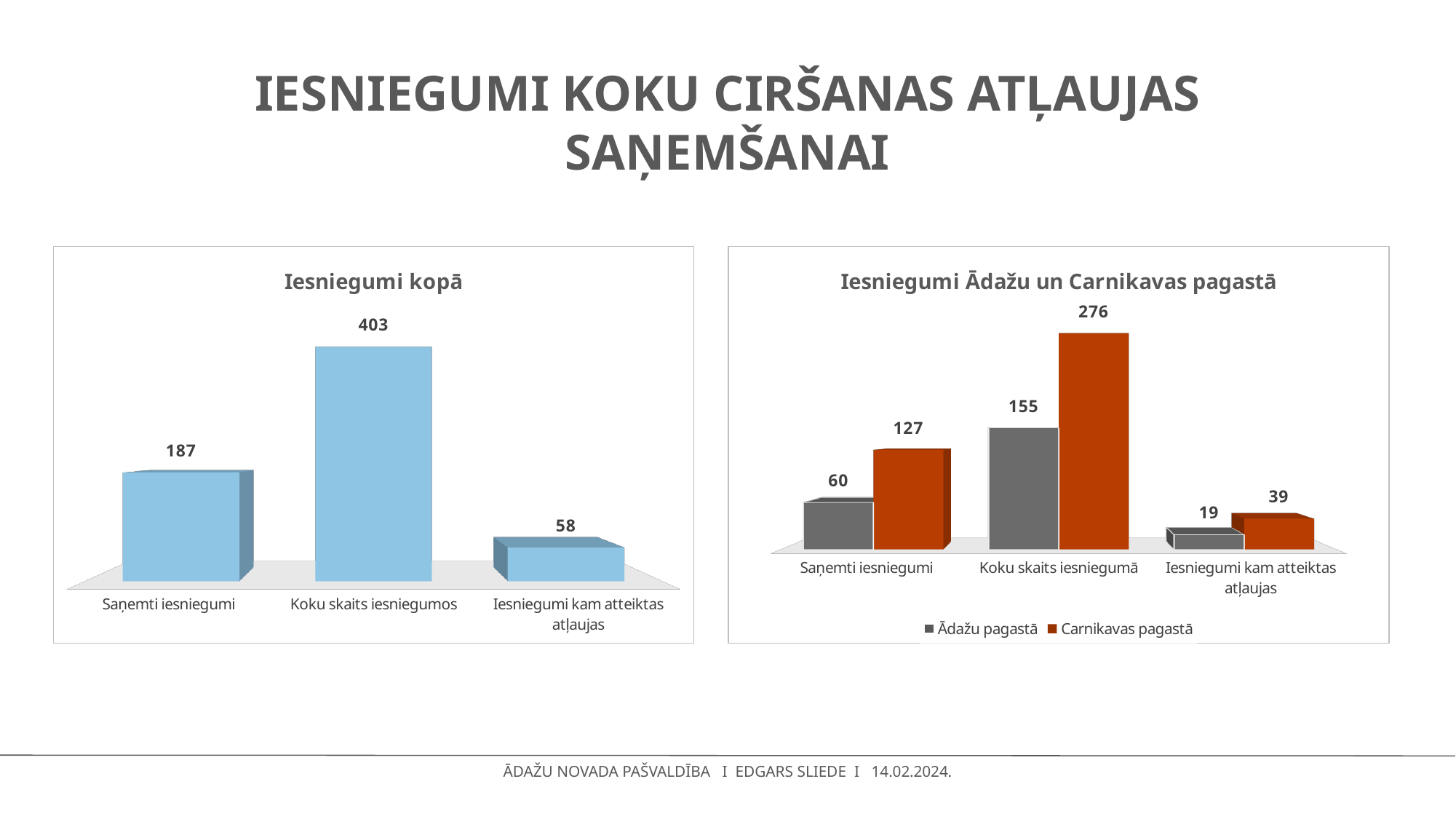
In the chart titled "Iesniegumi Ādažu un Carnikavas pagastā", what is the difference between Carnikavas pagastā and Ādažu pagastā for "Saņemti iesniegumi"? 67 In the chart titled "Iesniegumi kopā", how many categories are shown? 3 In the chart titled "Iesniegumi kopā", what is the difference between "Saņemti iesniegumi" and "Iesniegumi kam atteiktas atļaujas"? 129 In the chart titled "Iesniegumi Ādažu un Carnikavas pagastā", which is larger for "Iesniegumi kam atteiktas atļaujas": Ādažu pagastā or Carnikavas pagastā? Carnikavas pagastā In the chart titled "Iesniegumi Ādažu un Carnikavas pagastā", how many series does the legend list? 2 What kind of chart is the chart titled "Iesniegumi kopā"? Bar chart In the chart titled "Iesniegumi kopā", what is the value for "Koku skaits iesniegumos"? 403 In the chart titled "Iesniegumi Ādažu un Carnikavas pagastā", what colour are the bars for "Carnikavas pagastā"? Dark orange (red-brown) In the chart titled "Iesniegumi Ādažu un Carnikavas pagastā", which category has the highest value for "Ādažu pagastā"? Koku skaits iesniegumā In the chart titled "Iesniegumi kopā", which category has the lowest value? Iesniegumi kam atteiktas atļaujas In the chart titled "Iesniegumi Ādažu un Carnikavas pagastā", what is the value for "Ādažu pagastā" in "Saņemti iesniegumi"? 60 In the chart titled "Iesniegumi Ādažu un Carnikavas pagastā", what is the value for "Carnikavas pagastā" in "Koku skaits iesniegumā"? 276